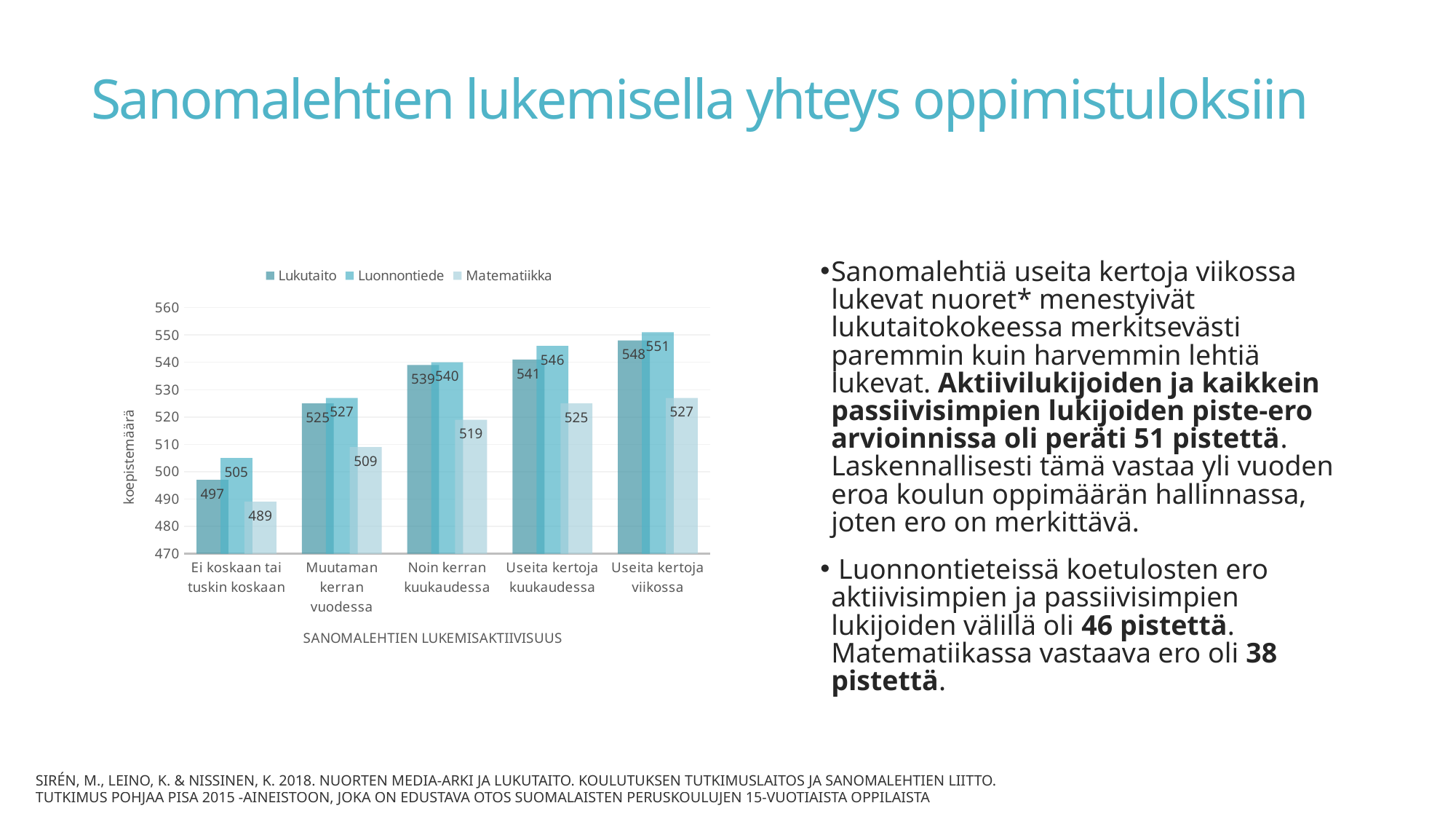
Which category has the lowest Matematiikka value? Ei koskaan tai tuskin koskaan Do the Lukutaito values rise or fall from left to right along the x axis? rise What is the Matematiikka value for 'Ei koskaan tai tuskin koskaan'? 489 What kind of chart is shown on the slide? bar chart Is the Luonnontiede value for 'Useita kertoja kuukaudessa' greater or less than 540? greater What is the difference between the Lukutaito values for 'Useita kertoja viikossa' and 'Ei koskaan tai tuskin koskaan'? 51 How many categories are shown on the x axis? 5 How many series does the legend list? 3 Which category has the highest Luonnontiede value? Useita kertoja viikossa What is the Luonnontiede value for 'Noin kerran kuukaudessa'? 540 Which is larger: the Matematiikka value for 'Muutaman kerran vuodessa' or for 'Noin kerran kuukaudessa'? Noin kerran kuukaudessa What is the Lukutaito value for 'Useita kertoja viikossa'? 548